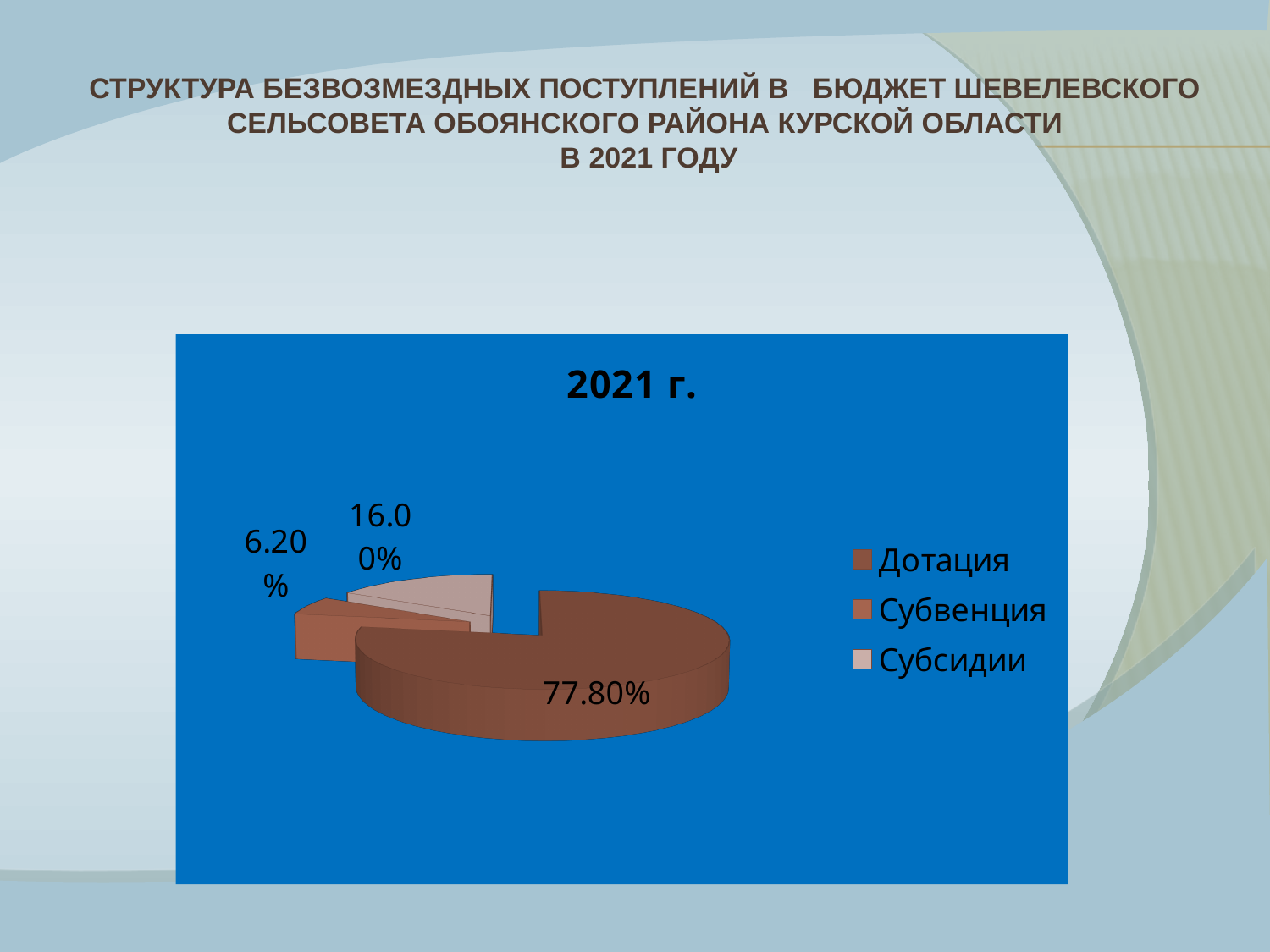
What is the chart's title? 2021 г. Which legend entry is shown in the lightest colour? Субсидии What share of the pie does Дотация have? 77.80% What kind of chart is shown on the slide? pie chart Which category has the smallest share of the pie? Субвенция What share of the pie does Субсидии have? 16.00% What is the difference between the shares of Дотация and Субсидии? 61.80% How many entries does the legend list? 3 How many slices does the pie chart have? 3 What share of the pie does Субвенция have? 6.20% Which is larger, the share for Субсидии or the share for Субвенция? Субсидии Which category has the largest share of the pie? Дотация